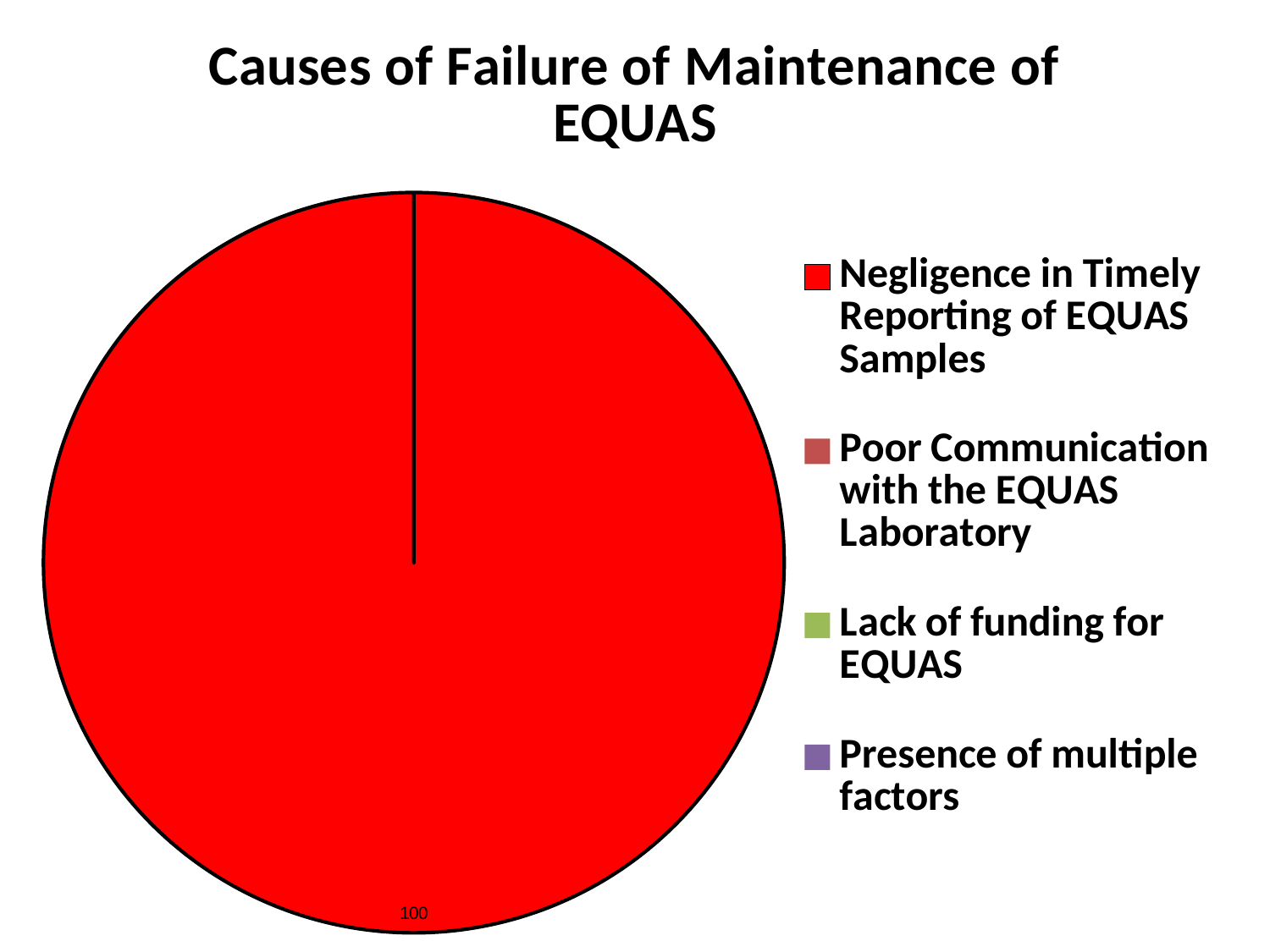
What value is printed on the slice for Negligence in Timely Reporting of EQUAS Samples? 100 What colour is the slice for Negligence in Timely Reporting of EQUAS Samples? red How many slices are visibly drawn in the pie? 1 What kind of chart is shown on the slide? pie chart How many entries does the legend list? 4 What is the title of the chart? Causes of Failure of Maintenance of EQUAS Which is larger, the slice for Negligence in Timely Reporting of EQUAS Samples or the slice for Lack of funding for EQUAS? Negligence in Timely Reporting of EQUAS Samples Which category occupies the entire pie? Negligence in Timely Reporting of EQUAS Samples Which category has the largest slice of the pie? Negligence in Timely Reporting of EQUAS Samples